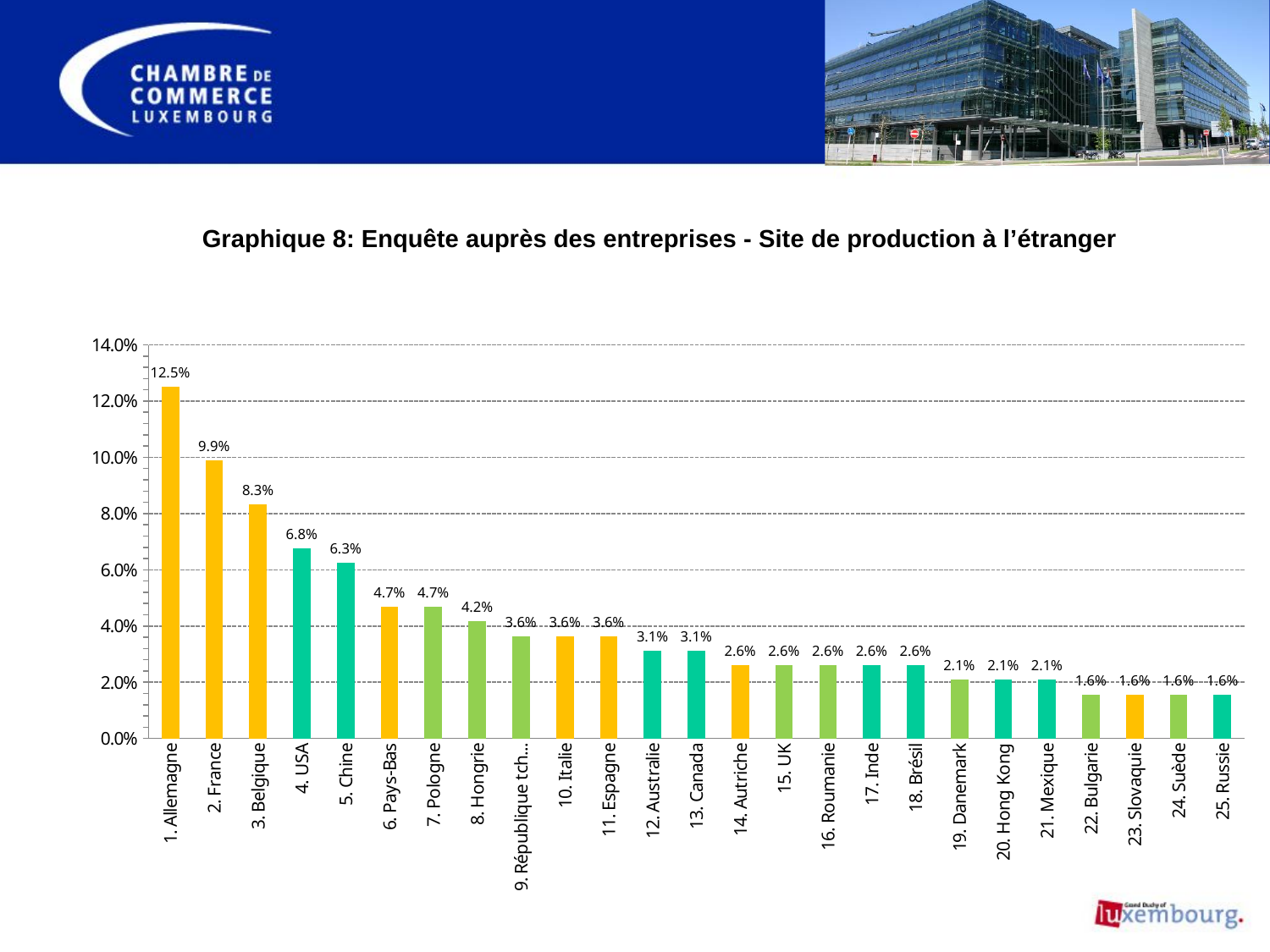
What is the difference between the values for 2. France and 3. Belgique? 1.6% Which category has the highest value? 1. Allemagne What is the difference between the values for 1. Allemagne and 25. Russie? 10.9% What is the title of the chart? Graphique 8: Enquête auprès des entreprises - Site de production à l'étranger What is the value for 5. Chine? 6.3% Which is larger, the value for 4. USA or the value for 6. Pays-Bas? 4. USA What is the value for 1. Allemagne? 12.5% What kind of chart is shown on the slide? bar chart How many categories are shown on the x axis? 25 Do the values rise or fall from left to right along the x axis? fall What is the value for 18. Brésil? 2.6% Is the value for 8. Hongrie greater or less than 4.0%? greater